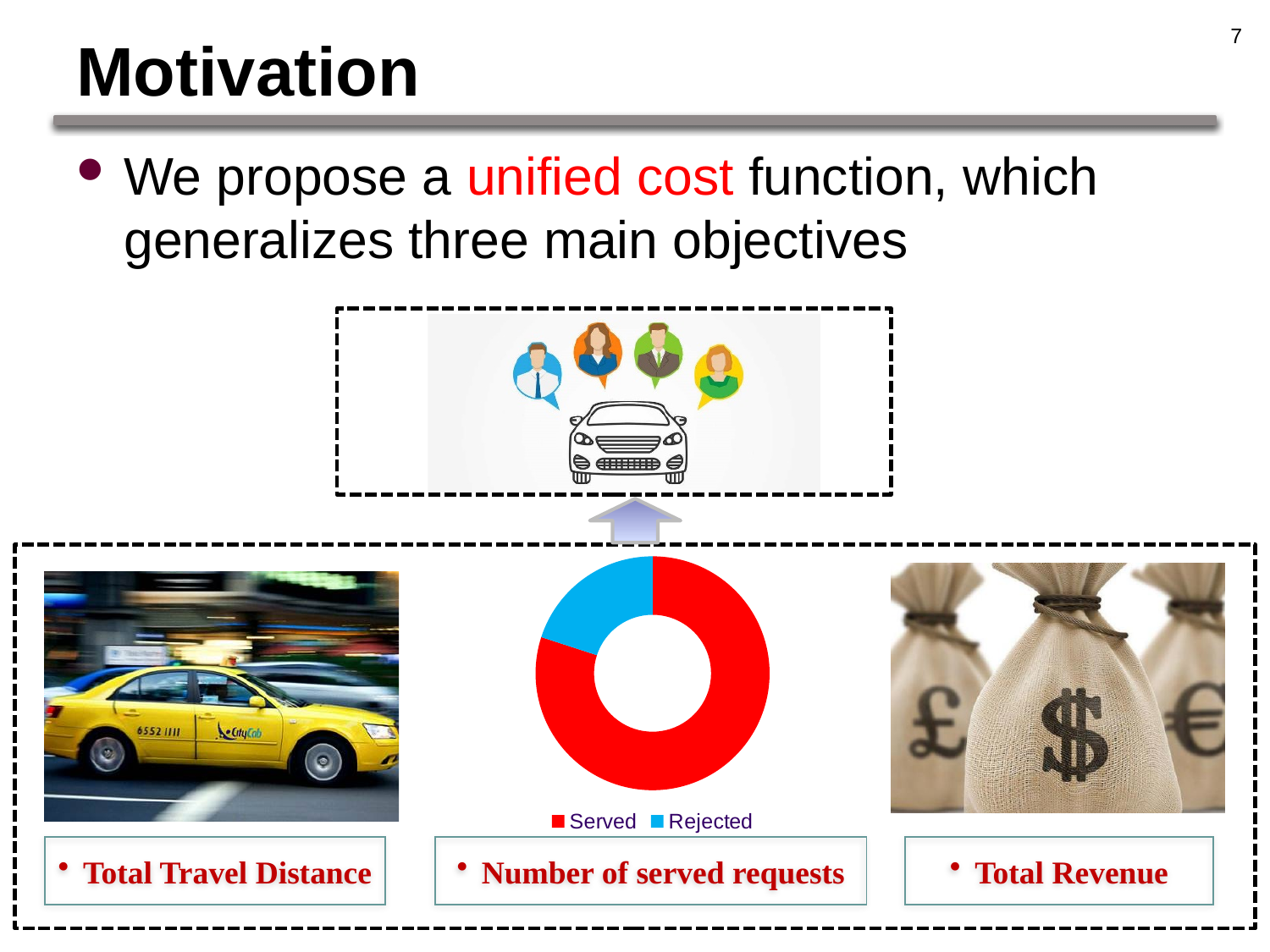
What colour represents Rejected in the doughnut chart? blue In the doughnut chart, which is larger: Served or Rejected? Served How many slices does the doughnut chart have? 2 Which slice of the doughnut chart is the largest? Served What kind of chart is shown in the middle of the bottom row of the slide? doughnut (pie) chart How many entries does the legend of the doughnut chart list? 2 Which slice of the doughnut chart is the smallest? Rejected What colour represents Served in the doughnut chart? red